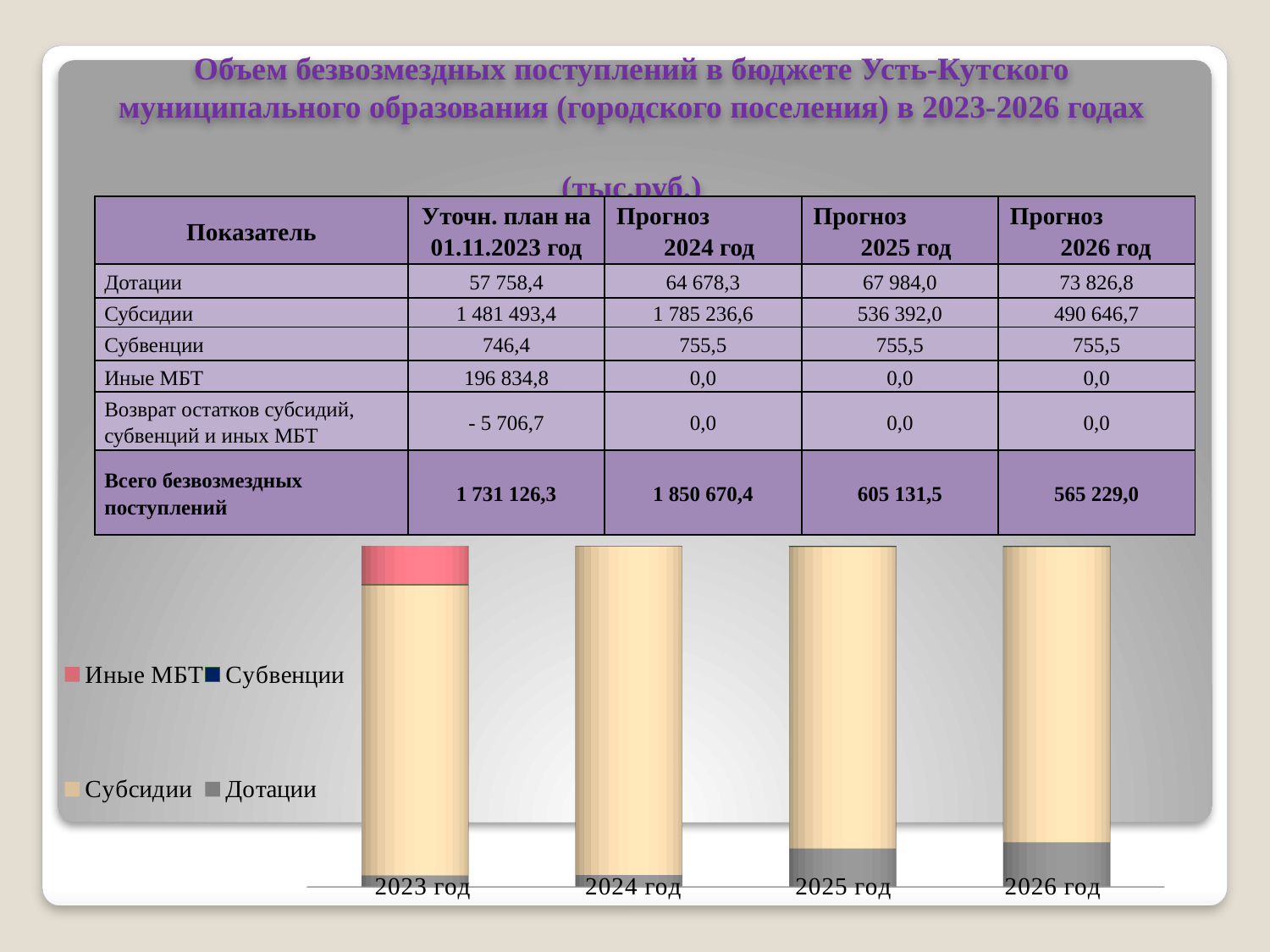
Which series is shown in pink in the chart legend? Иные МБТ Does the Дотации share of the bars rise or fall from 2023 год to 2026 год? rise How many year categories are shown along the x axis of the chart? 4 What is the label of the first bar on the left of the chart? 2023 год In which year's bar does the Иные МБТ segment appear? 2023 год Which series takes up the largest share of every bar in the chart? Субсидии Is the Дотации share of the bar larger in 2026 год or in 2024 год? 2026 год Is the Дотации share of the bar larger in 2025 год or in 2023 год? 2025 год What kind of chart is shown at the bottom of the slide? stacked bar chart How many series does the chart legend list? 4